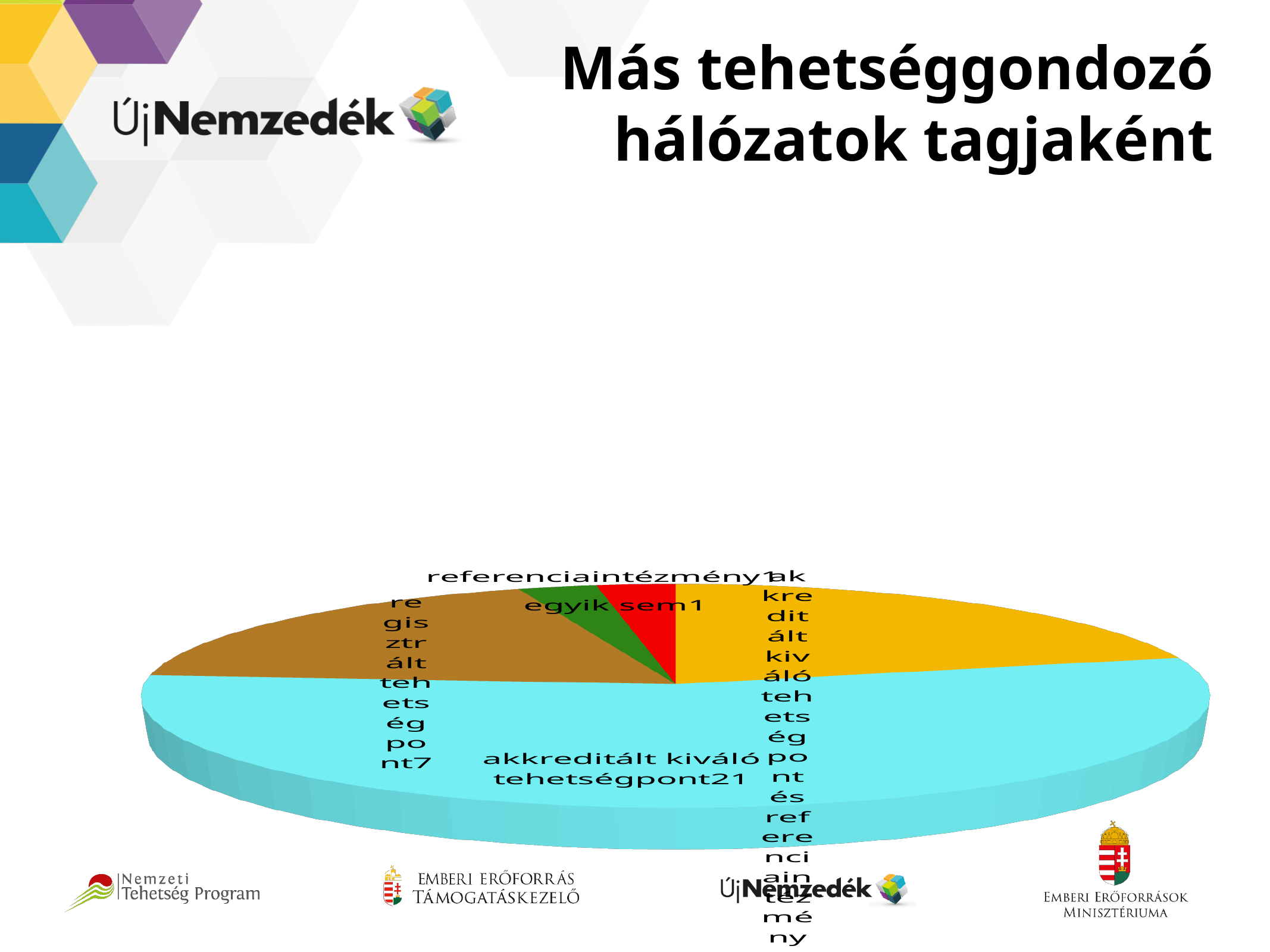
What colour is the slice for "akkreditált kiváló tehetségpont"? light blue What is the value for "referenciaintézmény"? 1 What is the difference between the values for "akkreditált kiváló tehetségpont" and "regisztrált tehetségpont"? 14 Which is larger, the value for "regisztrált tehetségpont" or the value for "akkreditált kiváló tehetségpont"? akkreditált kiváló tehetségpont What is the value for "regisztrált tehetségpont"? 7 Which category has the largest slice of the pie? akkreditált kiváló tehetségpont What kind of chart is shown on the slide? pie chart What is the title of the slide containing the pie chart? Más tehetséggondozó hálózatok tagjaként How many slices does the pie chart have? 5 What is the value for "akkreditált kiváló tehetségpont"? 21 What is the value for "egyik sem"? 1